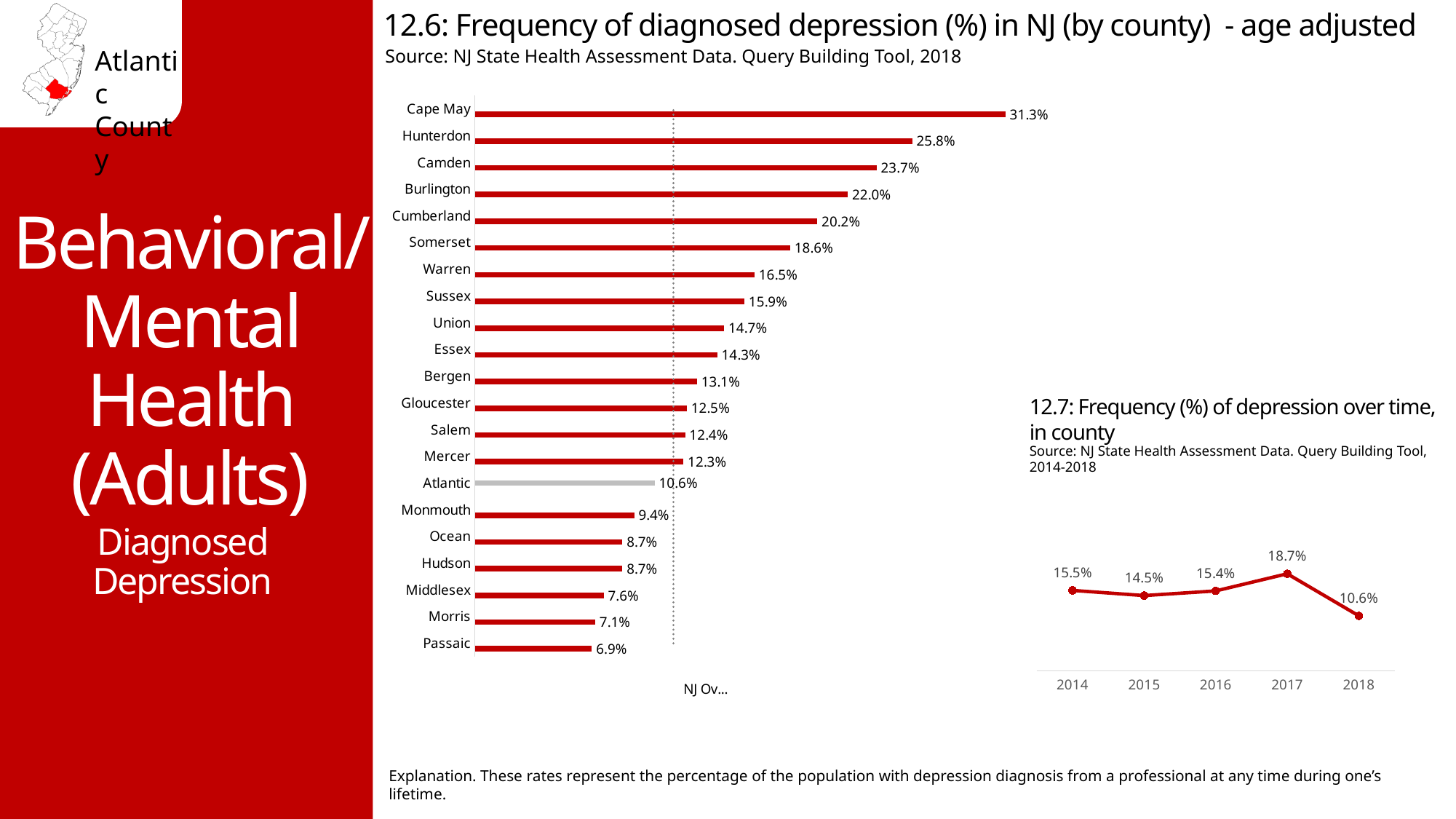
What kind of chart is chart 12.7? Line chart What kind of chart is chart 12.6? Bar chart In chart 12.7, what is the frequency of depression in 2017? 18.7% In chart 12.7, what is the difference between the 2017 and 2018 values? 8.1% In chart 12.6, what is the difference between Cape May and Hunterdon? 5.5% In chart 12.6, which county has a higher value, Camden or Somerset? Camden In chart 12.6, what is the frequency of diagnosed depression for Cape May? 31.3% How many counties are shown in chart 12.6? 21 In chart 12.6, which county has the highest frequency of diagnosed depression? Cape May In chart 12.6, which county has the lowest frequency of diagnosed depression? Passaic In chart 12.7, which year has the lowest frequency of depression? 2018 In chart 12.6, what is the value for Atlantic county? 10.6%